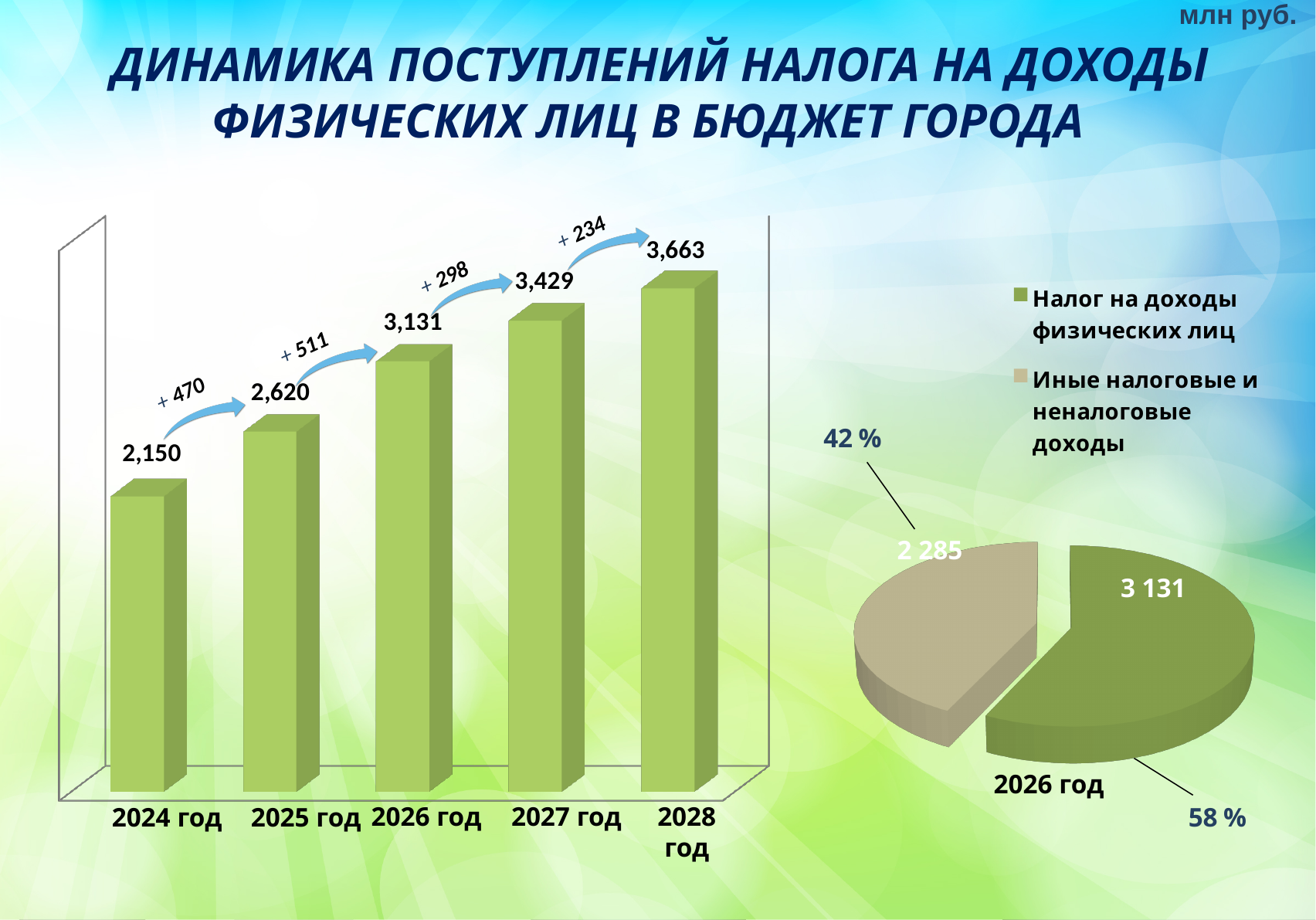
On the bar chart on the left, which year has the highest value? 2028 год On the pie chart on the right, what share does Иные налоговые и неналоговые доходы have? 42 % On the bar chart on the left, how many years are shown? 5 What kind of chart is shown on the left of the slide? bar chart On the bar chart on the left, which year has the lowest value? 2024 год On the bar chart on the left, do the values rise or fall from 2024 год to 2028 год? rise On the bar chart on the left, what is the difference between the values for 2025 год and 2024 год? 470 On the bar chart on the left, what is the value for 2024 год? 2,150 On the pie chart on the right, what is the value for Налог на доходы физических лиц? 3 131 On the bar chart on the left, what is the value for 2027 год? 3,429 How many series does the legend of the pie chart on the right list? 2 On the bar chart on the left, what is the difference between the values for 2028 год and 2027 год? 234